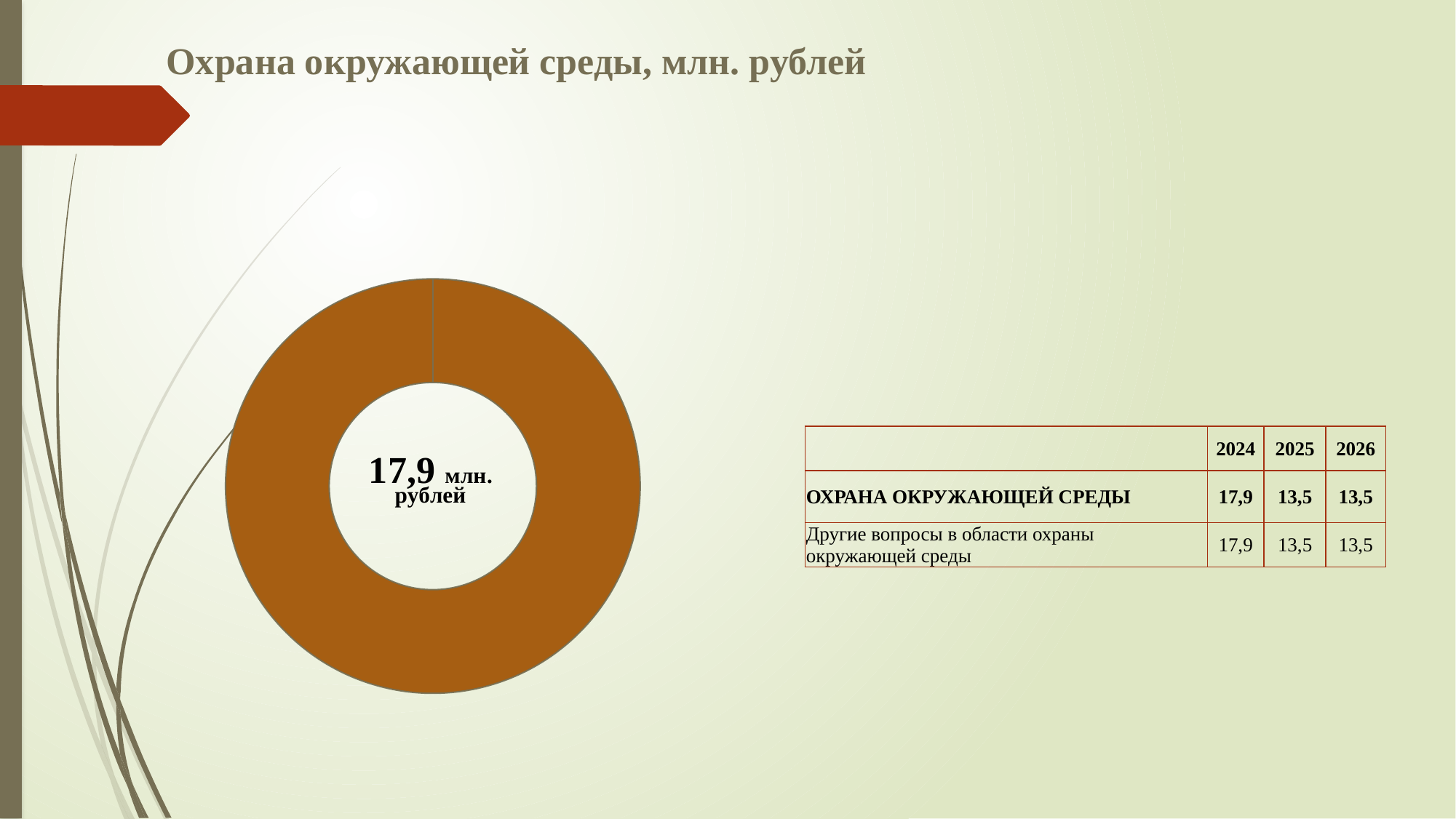
How many slices does the doughnut chart contain? 1 What value is printed in the centre of the doughnut chart? 17,9 млн. рублей Is the value shown in the centre of the doughnut chart greater or less than 15? greater What share of the doughnut chart does the single slice occupy? 100% What is the title of the slide containing the doughnut chart? Охрана окружающей среды, млн. рублей What kind of chart is shown on the slide? doughnut chart What colour is the slice of the doughnut chart? brown